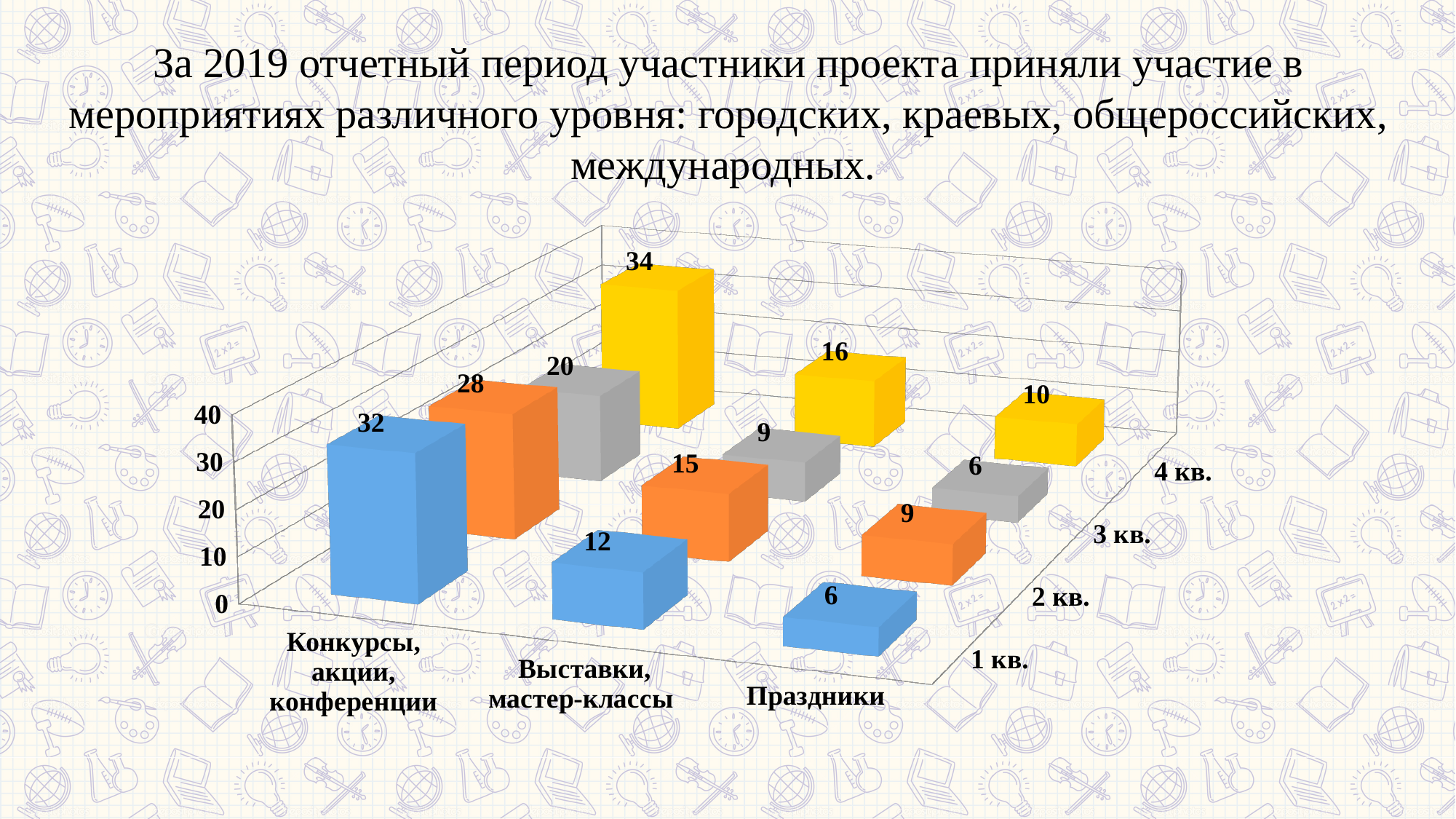
What is the value for Конкурсы, акции, конференции in 3 кв.? 20 What is the value for Конкурсы, акции, конференции in 1 кв.? 32 Which quarter has the highest value for Конкурсы, акции, конференции? 4 кв. What kind of chart is shown on the slide? 3D bar chart Which category has the lowest value in 1 кв.? Праздники What is the difference between the 4 кв. and 1 кв. values for Конкурсы, акции, конференции? 2 What is the difference between Выставки, мастер-классы and Праздники in 2 кв.? 6 What is the value for Праздники in 2 кв.? 9 How many categories are shown on the horizontal axis of the chart? 3 What is the value for Выставки, мастер-классы in 4 кв.? 16 Which is larger: Выставки, мастер-классы in 3 кв. or Праздники in 4 кв.? Праздники in 4 кв. How many quarters (series) are plotted in the chart? 4